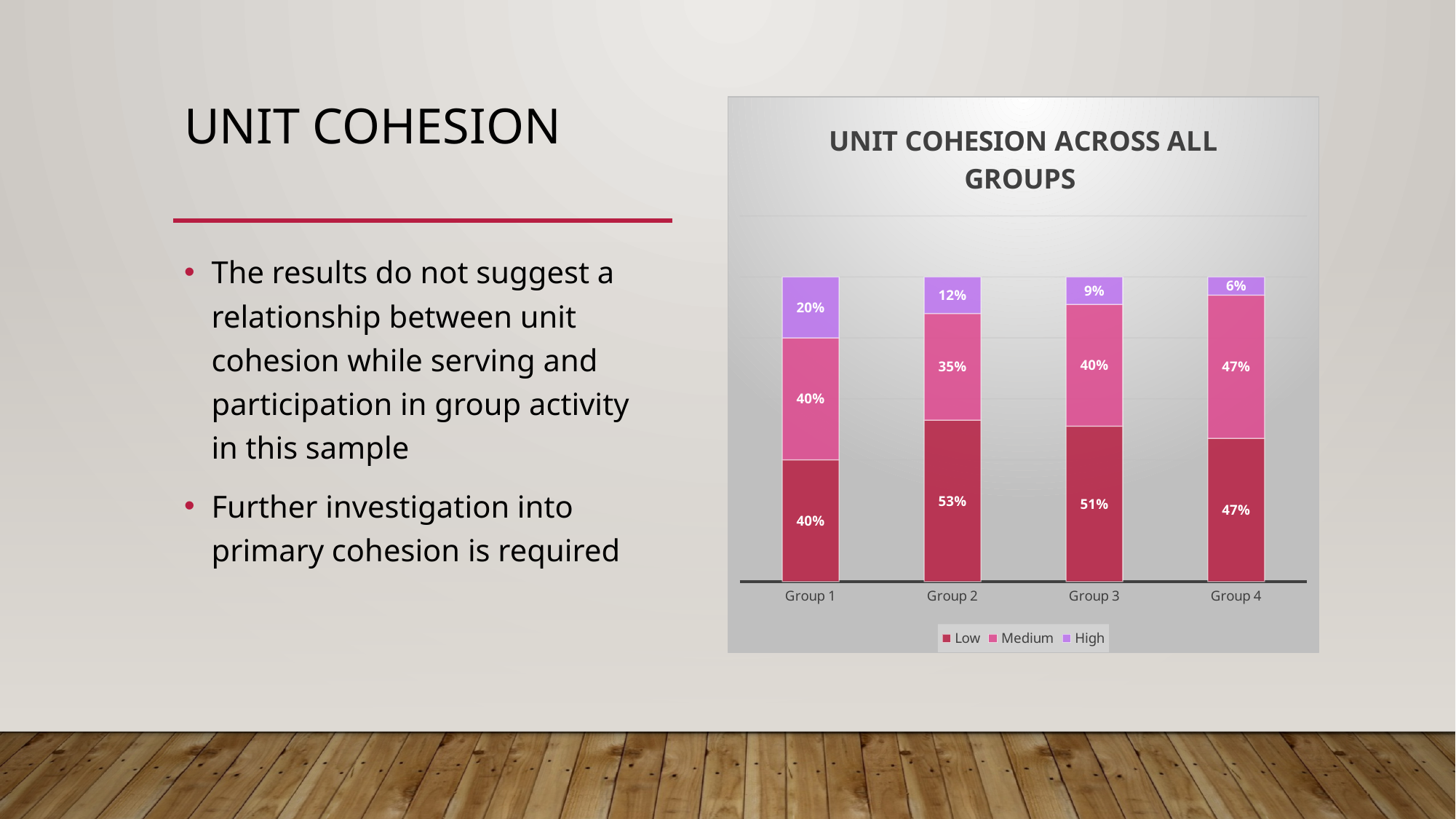
Do the High values rise or fall from Group 1 to Group 4? Fall What is the High value for Group 1? 20% What is the title of the chart? Unit Cohesion Across All Groups Which group has the highest Low value? Group 2 What is the difference between the High values for Group 1 and Group 4? 14% How many groups are shown on the x axis? 4 Which is larger, the Medium value for Group 2 or the Medium value for Group 3? Group 3 What is the Medium value for Group 4? 47% What kind of chart is shown? Stacked bar chart Which group has the lowest High value? Group 4 How many series does the legend list? 3 What is the Low value for Group 2? 53%